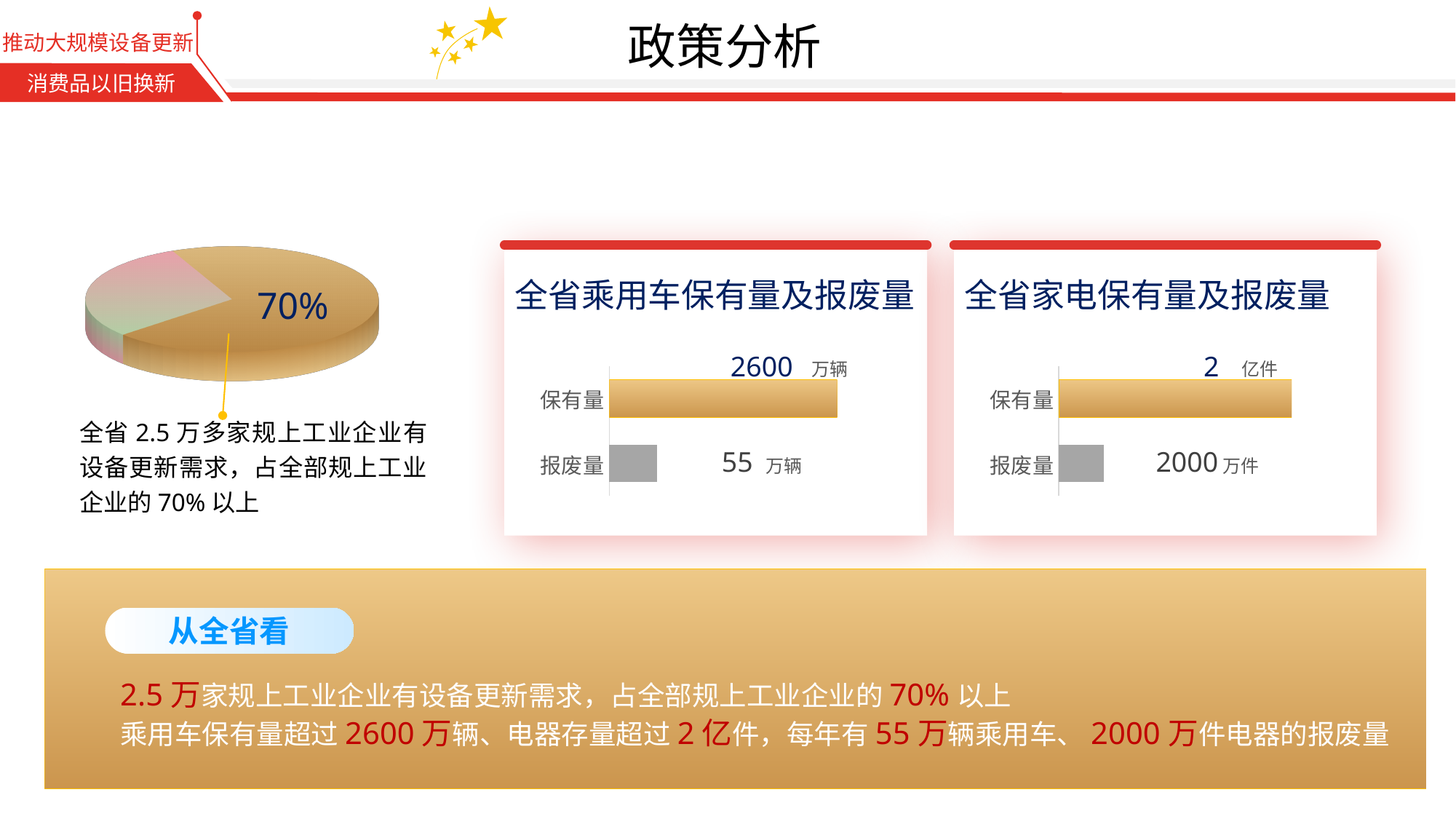
In the chart titled 全省家电保有量及报废量, what is the value for 保有量? 2 亿件 What kind of chart is the chart titled 全省乘用车保有量及报废量? bar chart How many categories are shown in the chart titled 全省家电保有量及报废量? 2 In the chart titled 全省乘用车保有量及报废量, what is the value for 报废量? 55 万辆 In the chart titled 全省乘用车保有量及报废量, what is the value for 保有量? 2600 万辆 In the pie chart on the left, what share does the large gold slice represent? 70% In the chart titled 全省乘用车保有量及报废量, what colour is the 报废量 bar? grey In the chart titled 全省乘用车保有量及报废量, which category has the higher value? 保有量 What kind of chart is the chart on the left of the slide? pie chart In the chart titled 全省乘用车保有量及报废量, what is the difference between 保有量 and 报废量? 2545 万辆 In the chart titled 全省家电保有量及报废量, which category has the lower value? 报废量 In the chart titled 全省家电保有量及报废量, what is the value for 报废量? 2000 万件